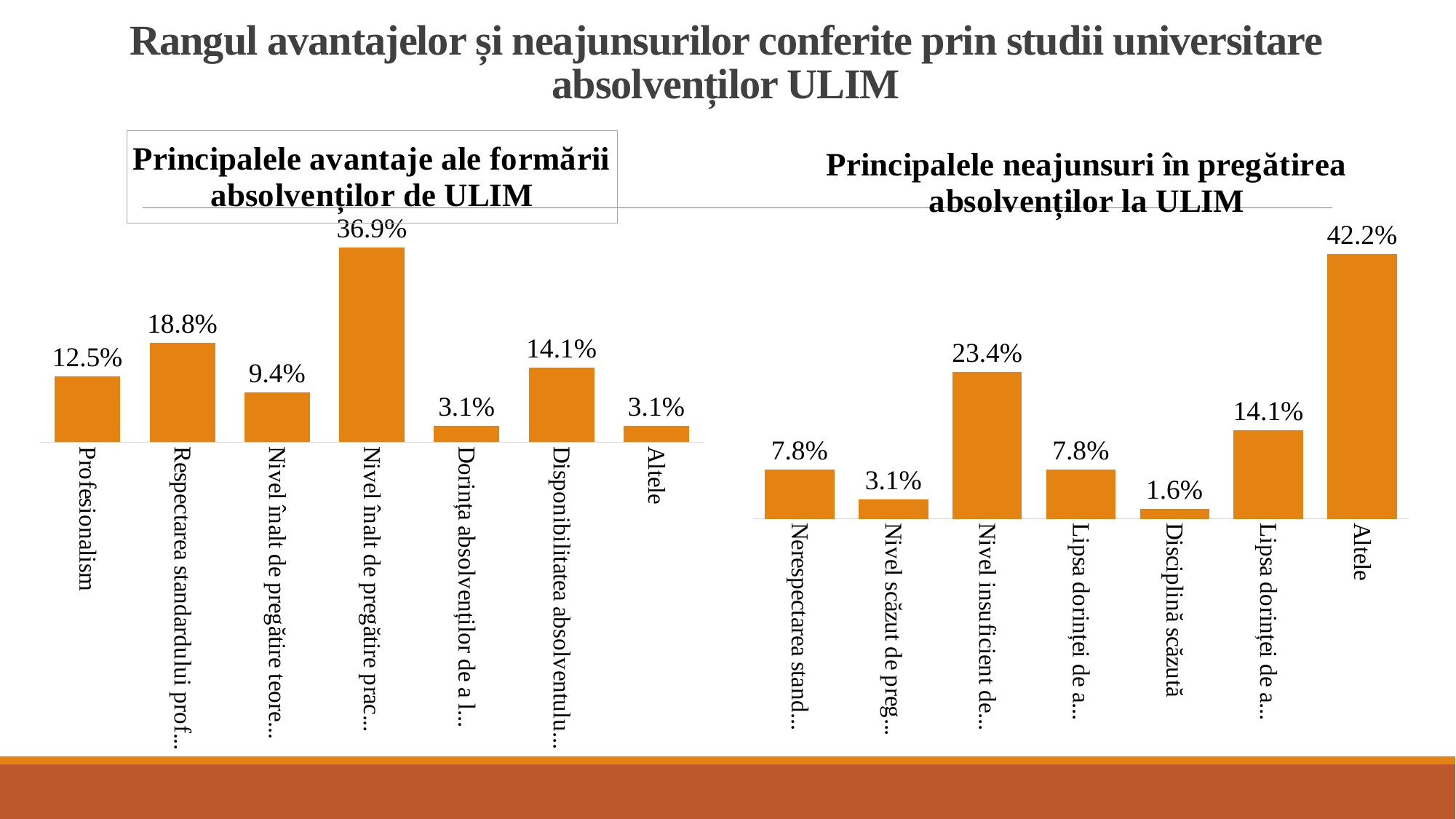
In the left chart (Principalele avantaje ale formării absolvenților de ULIM), how many bars are plotted? 7 In the left chart (Principalele avantaje ale formării absolvenților de ULIM), what is the difference between the second bar (18.8%) and Profesionalism? 6.3% In the right chart (Principalele neajunsuri în pregătirea absolvenților la ULIM), which category has the lowest value? Disciplină scăzută What type of chart is used on this slide? Bar chart Which is larger: the value for Altele in the left chart or the value for Altele in the right chart? Altele in the right chart In the right chart (Principalele neajunsuri în pregătirea absolvenților la ULIM), what is the value for Altele? 42.2% In the left chart (Principalele avantaje ale formării absolvenților de ULIM), what is the value for Profesionalism? 12.5% In the right chart (Principalele neajunsuri în pregătirea absolvenților la ULIM), which category has the highest value? Altele In the left chart (Principalele avantaje ale formării absolvenților de ULIM), what is the value of the highest bar? 36.9% In the right chart (Principalele neajunsuri în pregătirea absolvenților la ULIM), what is the value for Disciplină scăzută? 1.6% In the right chart (Principalele neajunsuri în pregătirea absolvenților la ULIM), how many categories are shown? 7 In the left chart (Principalele avantaje ale formării absolvenților de ULIM), what is the value for Altele? 3.1%